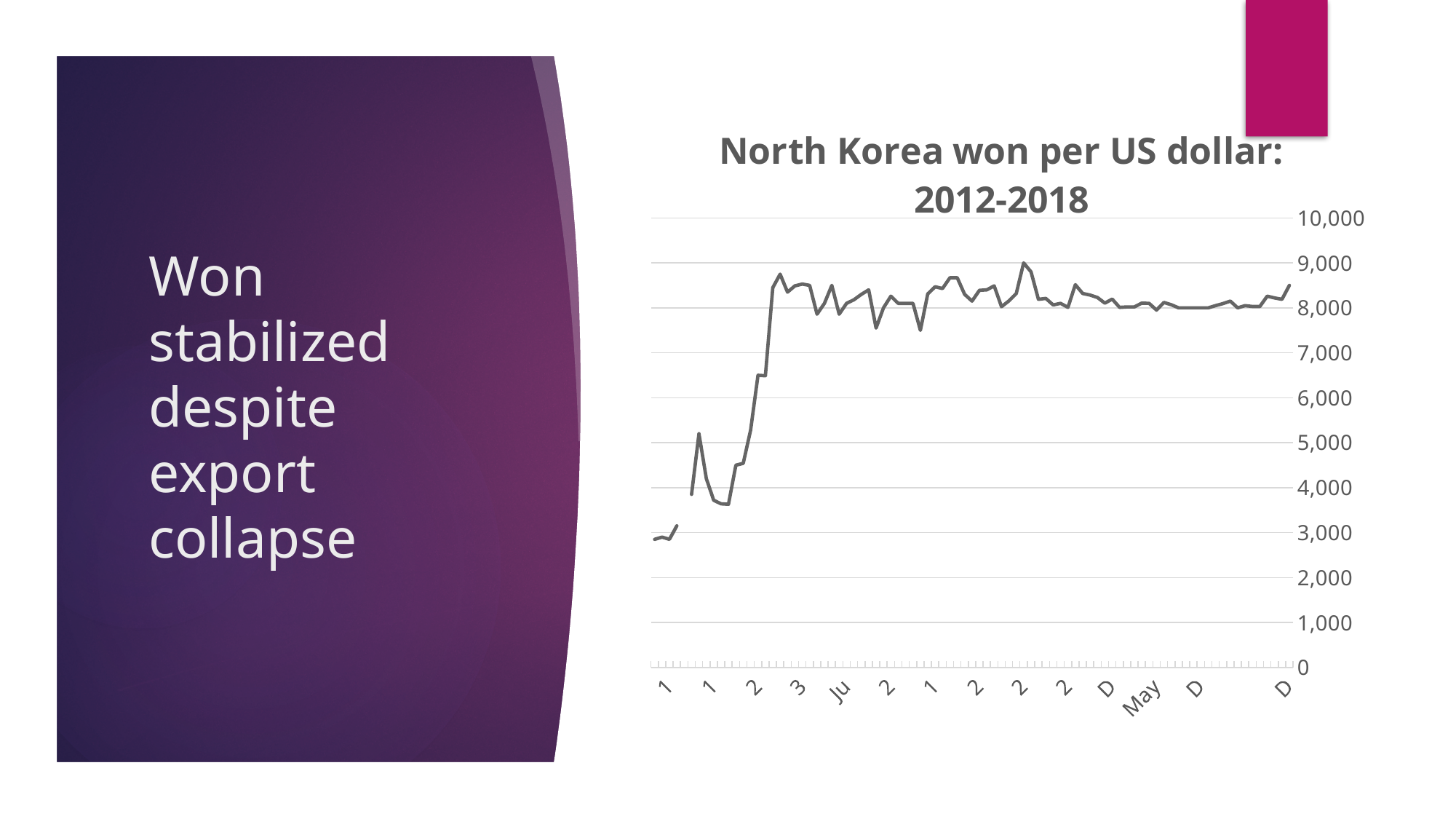
Is the value at the start of the series greater or less than 2,000? greater Does the line ever exceed 10,000? No Is the highest value reached by the line greater or less than 7,000? greater What is the title of the chart? North Korea won per US dollar: 2012-2018 Which is larger, the value at the start of the series or the value at the end of the series? The value at the end What kind of chart is shown on the slide? Line chart What is the highest tick value shown on the vertical axis? 10,000 Overall, does the won per US dollar value rise or fall from the start of the series to the end? Rise